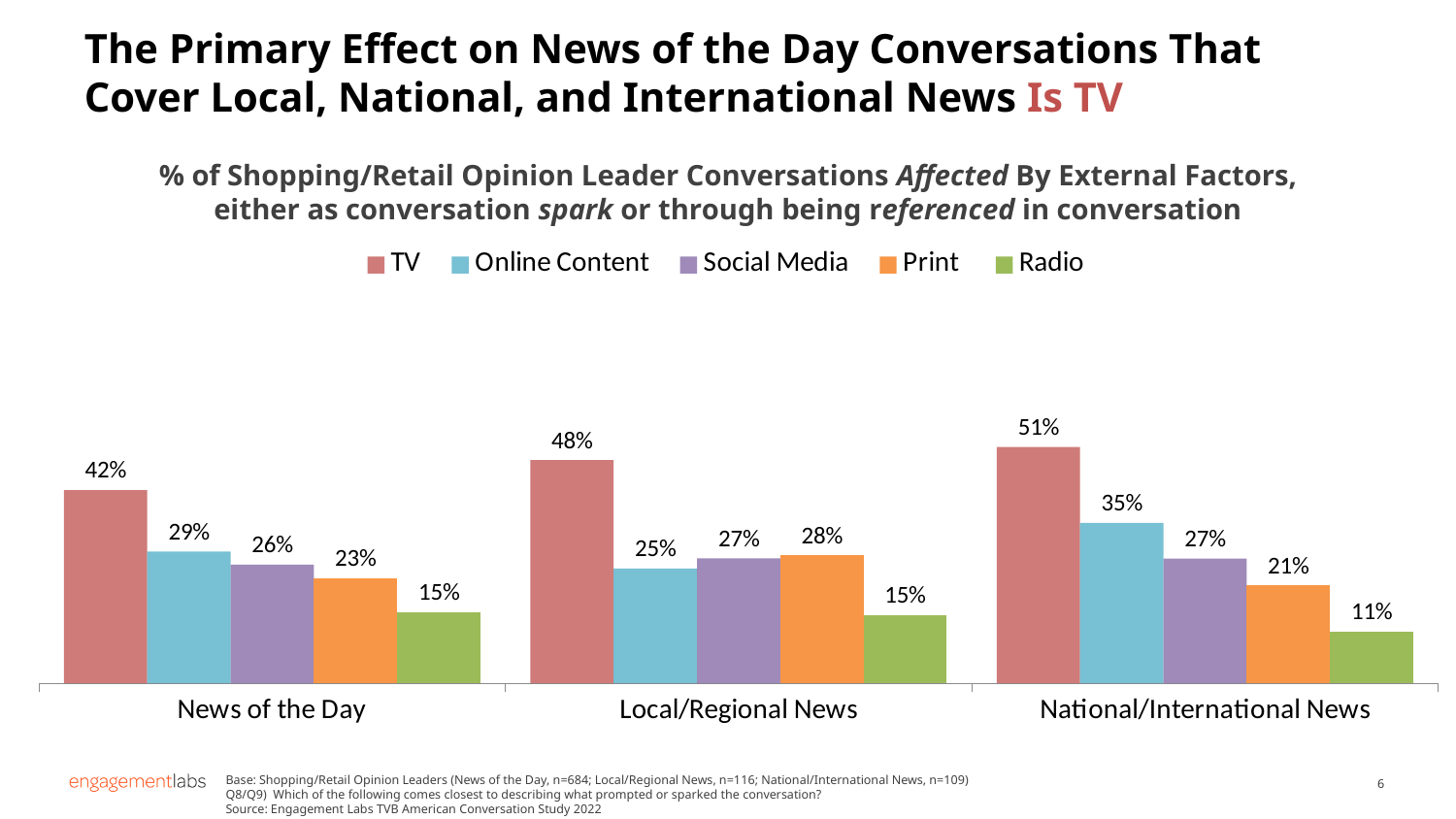
What is the value for Radio in the News of the Day category? 15% Do the TV values rise or fall from News of the Day to National/International News? Rise What is the difference between the TV value and the Online Content value in the News of the Day category? 13% How many categories are shown on the x axis? 3 How many series does the legend list? 5 What kind of chart is shown on the slide? Bar chart Which is larger in the Local/Regional News category: Social Media or Print? Print Which series is shown in green in the legend? Radio Which series has the lowest value in the National/International News category? Radio Which series has the highest value in the Local/Regional News category? TV What is the value for TV in the National/International News category? 51% What is the value for Print in the Local/Regional News category? 28%